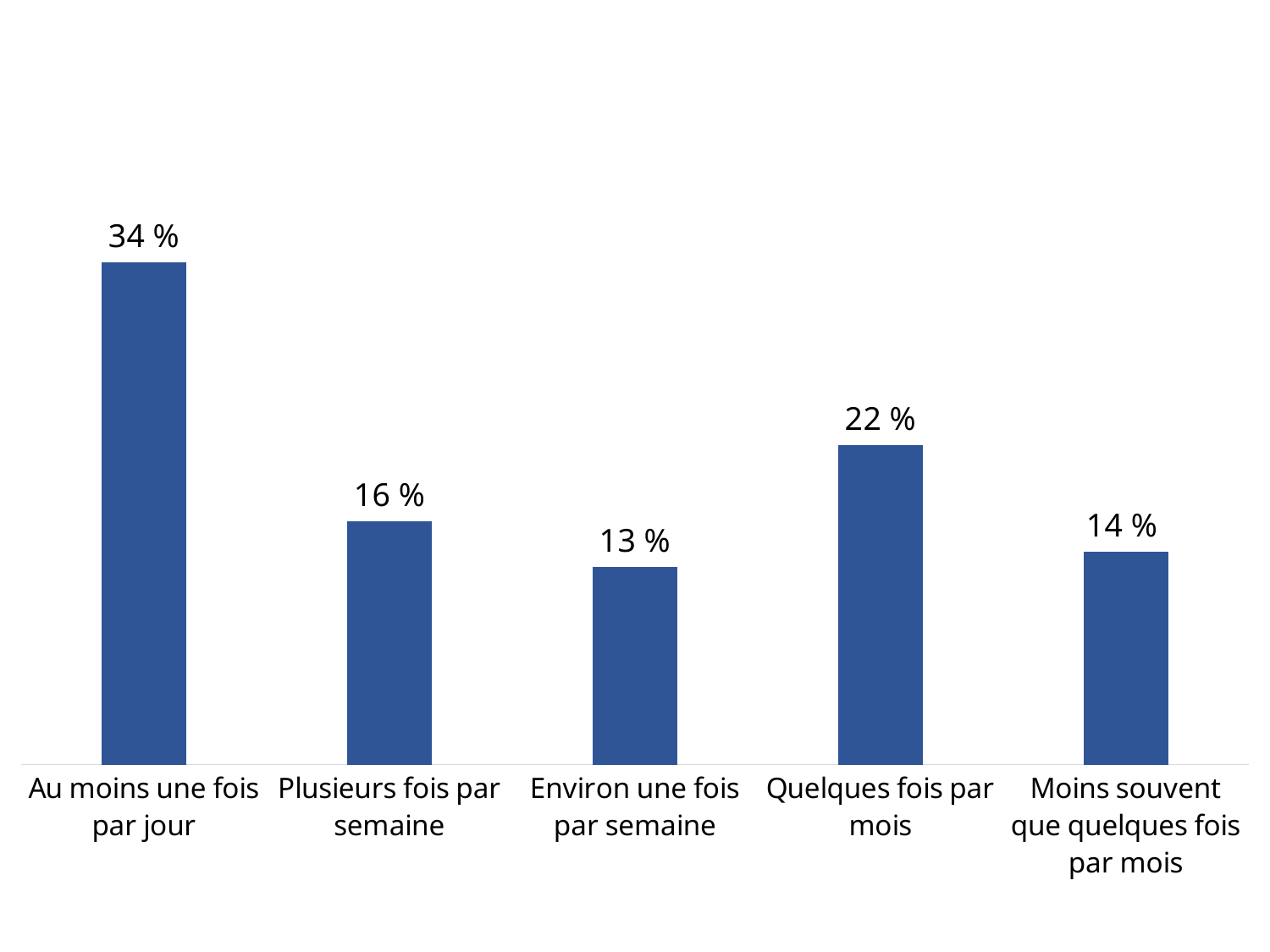
What is the value for "Quelques fois par mois"? 22 % What kind of chart is shown on the slide? Bar chart What is the value for "Environ une fois par semaine"? 13 % Which is larger, the value for "Quelques fois par mois" or the value for "Plusieurs fois par semaine"? Quelques fois par mois Which category has the lowest value? Environ une fois par semaine How many categories are shown in the chart? 5 What is the difference between the values for "Au moins une fois par jour" and "Quelques fois par mois"? 12 % What is the value for "Au moins une fois par jour"? 34 % What is the value for "Moins souvent que quelques fois par mois"? 14 % Which category has the highest value? Au moins une fois par jour What is the value for "Plusieurs fois par semaine"? 16 % What is the difference between the values for "Plusieurs fois par semaine" and "Environ une fois par semaine"? 3 %